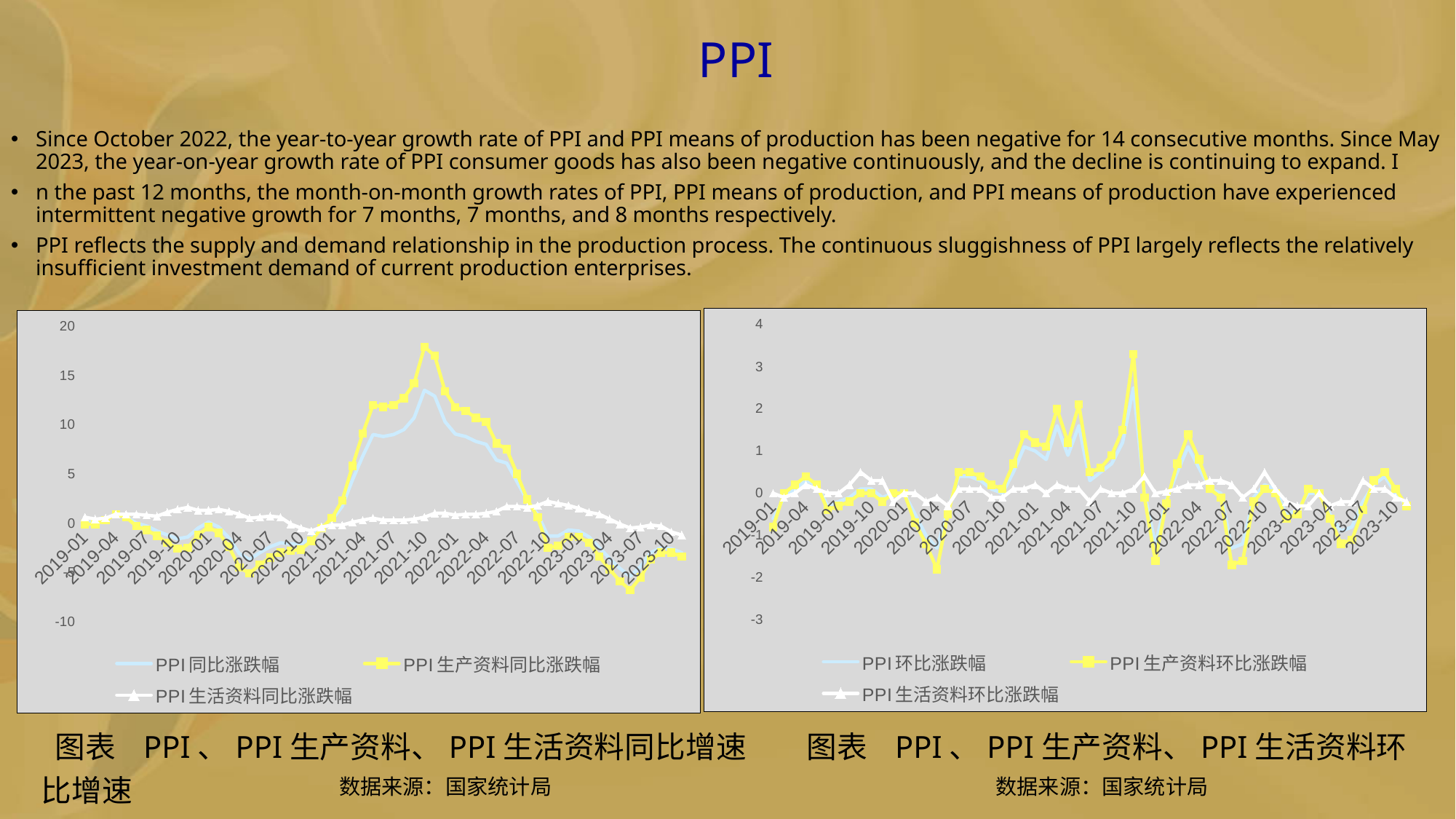
In the left chart, is the peak value of PPI生产资料同比涨跌幅 around 2021-10 greater or less than 15? greater In the left chart, is the peak value of PPI同比涨跌幅 around 2021-10 greater or less than 10? greater What kind of chart is the right chart (PPI、PPI生产资料、PPI生活资料环比增速)? line chart What is the data source stated below the charts? 国家统计局 In the right chart, is the value of PPI生产资料环比涨跌幅 around 2020-04 greater or less than -1? less How many series does the legend of the left chart list? 3 How many series does the legend of the right chart list? 3 In the right chart, which series reaches the highest peak? PPI生产资料环比涨跌幅 What kind of chart is the left chart (PPI、PPI生产资料、PPI生活资料同比增速)? line chart In the left chart, which series reaches the highest peak? PPI生产资料同比涨跌幅